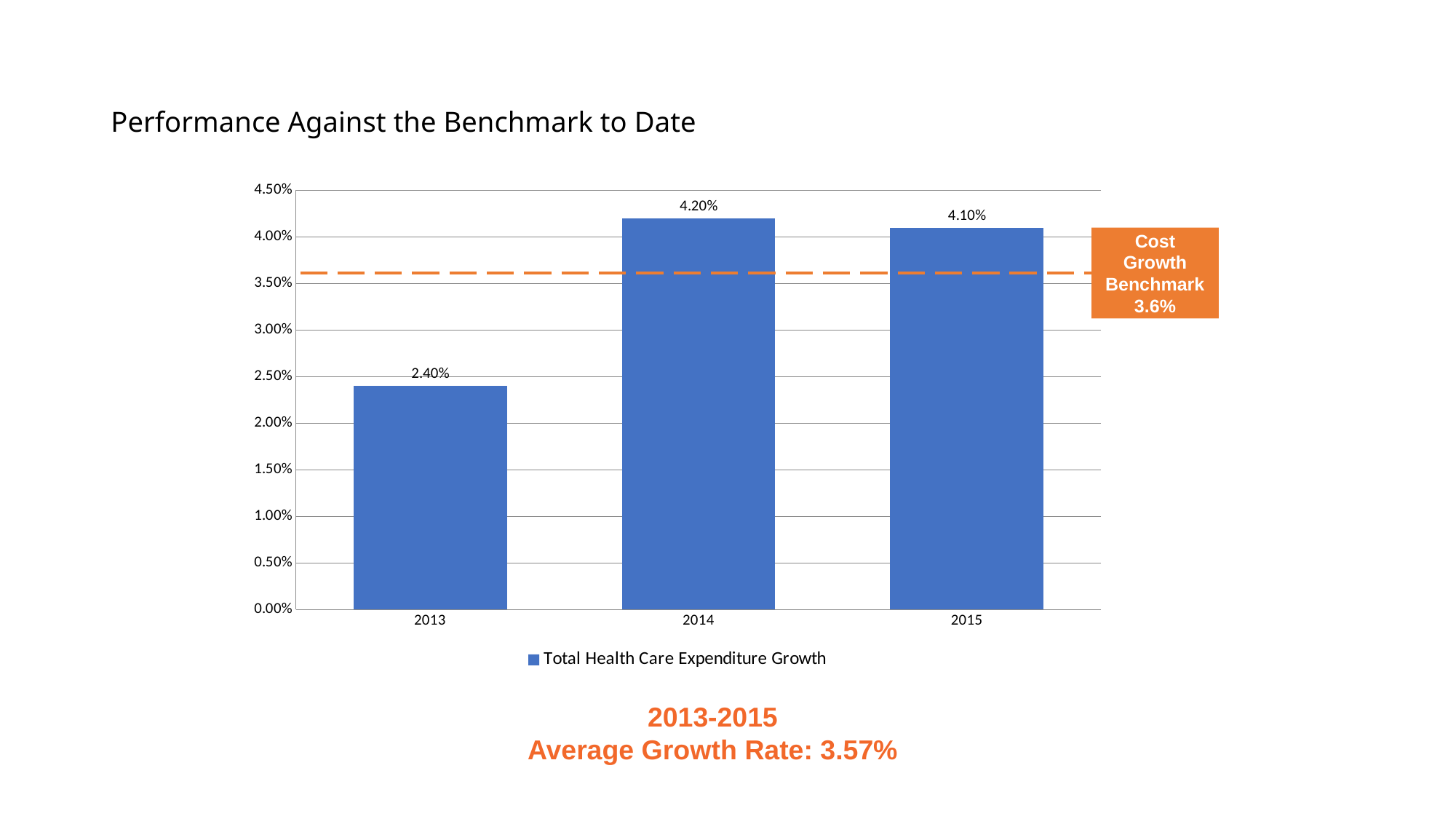
How many years are shown on the x axis of the chart? 3 What value does the dashed orange Cost Growth Benchmark line represent? 3.6% What is the Total Health Care Expenditure Growth value for 2015? 4.10% What kind of chart is shown on the slide? bar chart What is the Total Health Care Expenditure Growth value for 2013? 2.40% Which year has a larger Total Health Care Expenditure Growth, 2013 or 2015? 2015 Which year has the highest Total Health Care Expenditure Growth? 2014 How many series does the chart legend list? 1 Which year has the lowest Total Health Care Expenditure Growth? 2013 What is the difference between the 2014 and 2013 Total Health Care Expenditure Growth values? 1.80% Is the value for 2013 greater or less than 3.00%? less What is the Total Health Care Expenditure Growth value for 2014? 4.20%